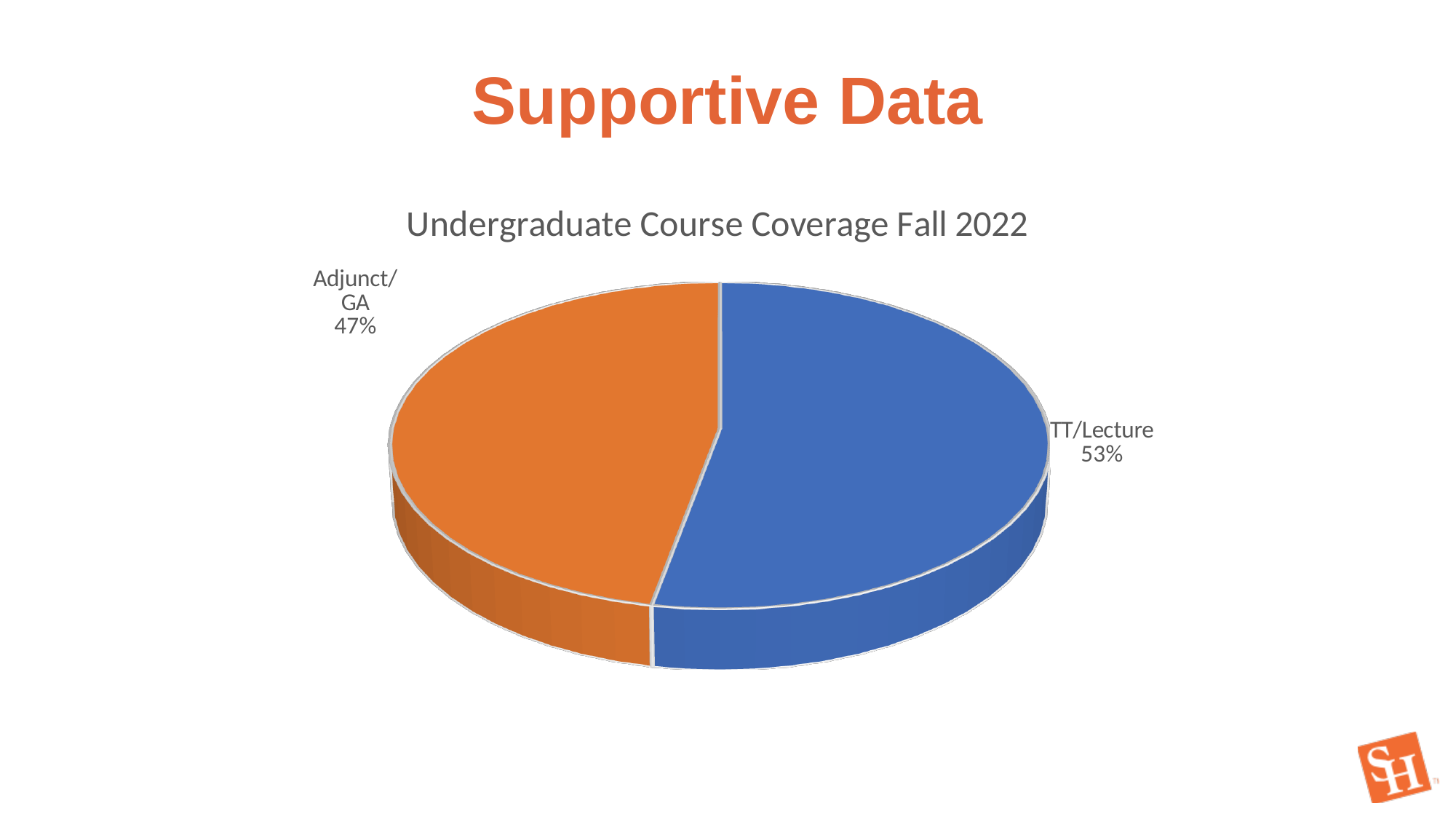
What is the title of the chart? Undergraduate Course Coverage Fall 2022 What share of undergraduate course coverage is attributed to Adjunct/GA? 47% Which category has the smallest share of the pie? Adjunct/GA Is the Adjunct/GA share greater or less than 50%? less What is the difference in percentage points between the TT/Lecture and Adjunct/GA shares? 6 What kind of chart is shown on the slide? Pie chart Which is larger, the TT/Lecture share or the Adjunct/GA share? TT/Lecture What colour is the TT/Lecture slice? Blue Which category has the largest share of the pie? TT/Lecture How many categories are shown in the pie chart? 2 What share of undergraduate course coverage is attributed to TT/Lecture? 53%